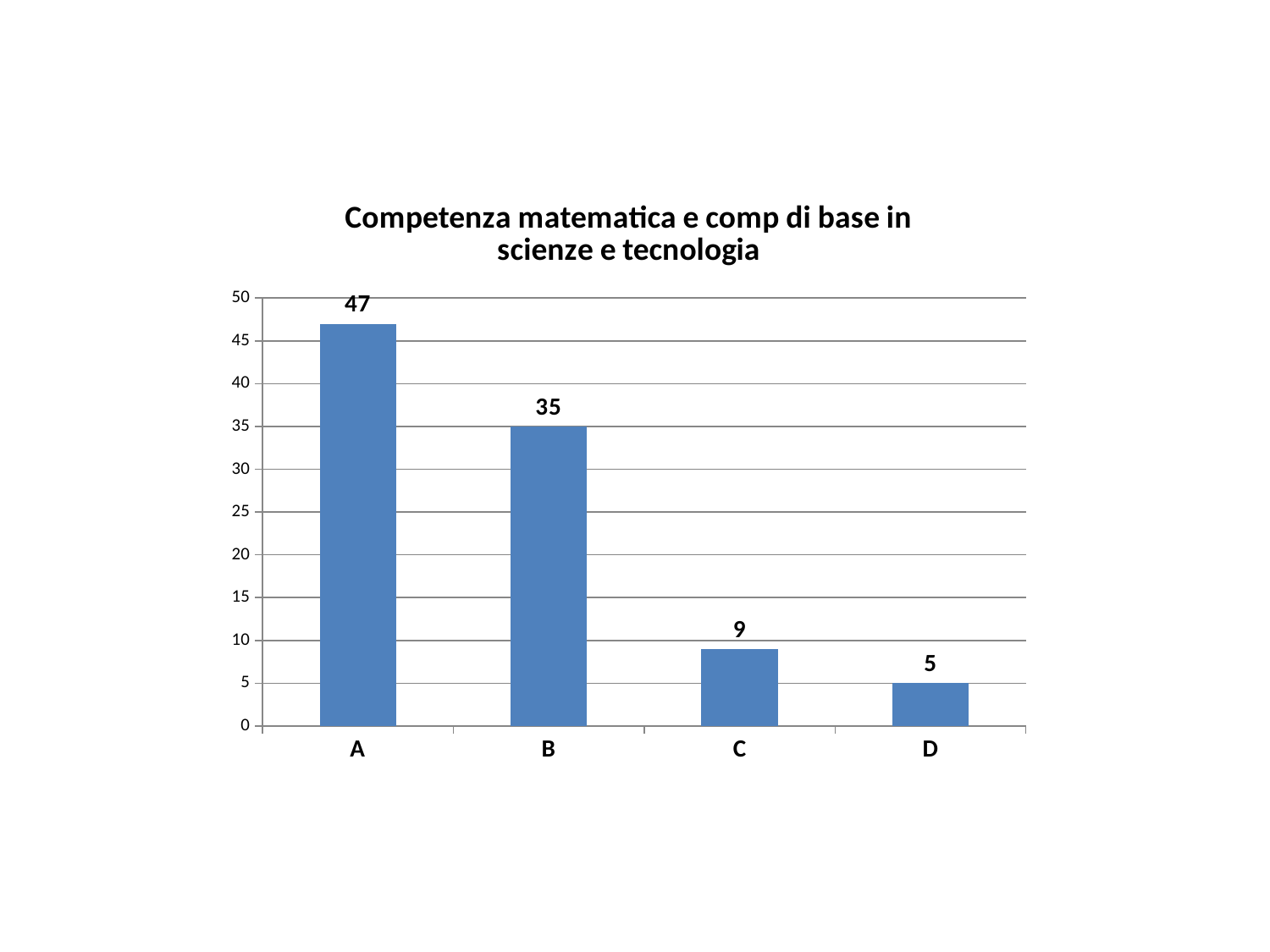
Which is larger, the value for B or the value for C? B What is the difference between the values for C and D? 4 Which category has the lowest value? D What kind of chart is shown on the slide? Bar chart What is the value for category C? 9 How many categories are shown on the x axis? 4 What is the value for category B? 35 What is the value for category A? 47 What is the difference between the values for A and B? 12 What is the value for category D? 5 Which category has the highest value? A Do the values rise or fall from A to D along the x axis? Fall